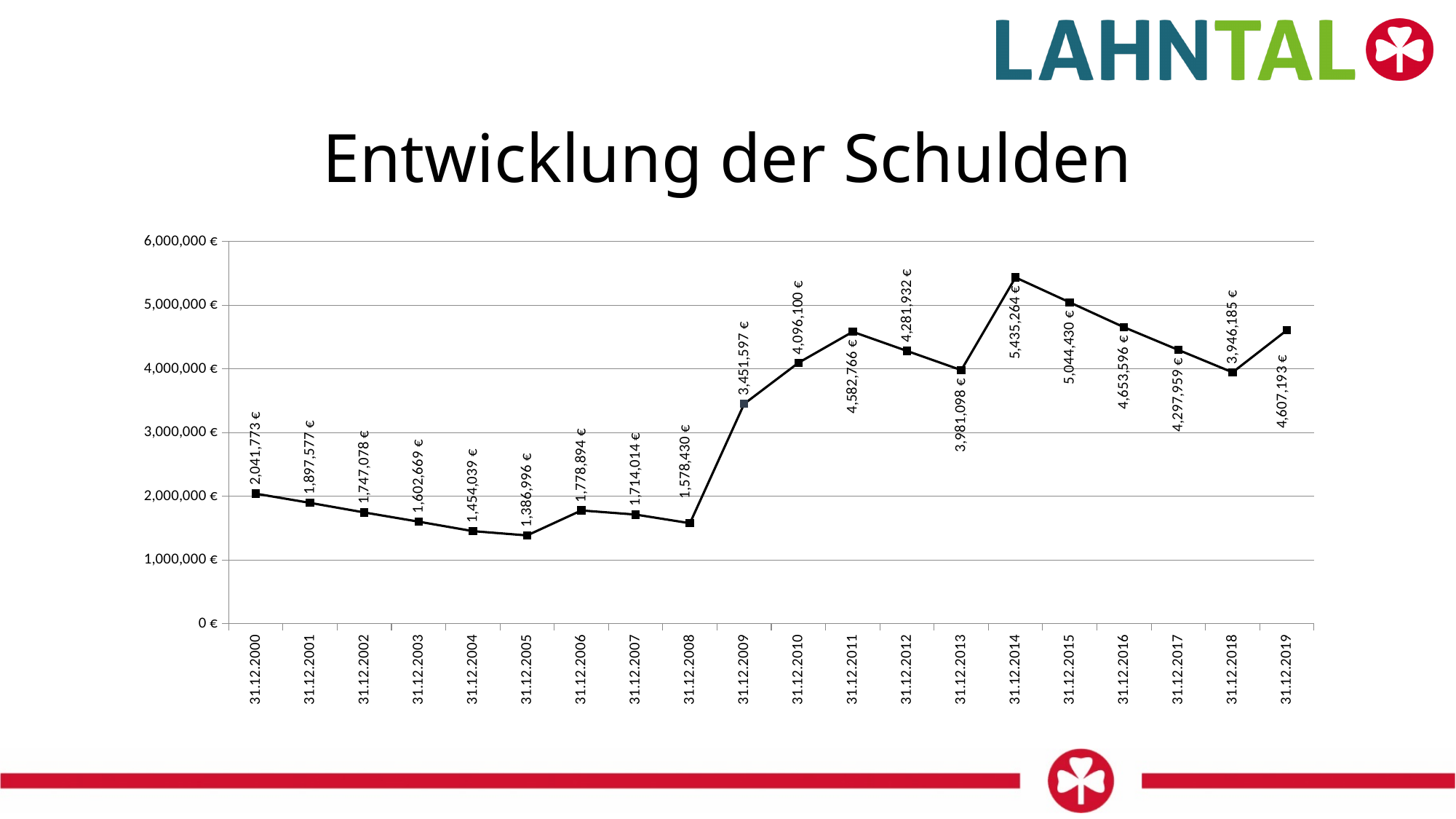
What is the difference between the values for 31.12.2009 and 31.12.2008? 1,873,167 € What type of chart is shown on the slide? line chart What is the difference between the values for 31.12.2014 and 31.12.2013? 1,454,166 € Which date has the highest value? 31.12.2014 What is the title of the chart? Entwicklung der Schulden How many data points are plotted on the chart? 20 Which is larger, the value for 31.12.2016 or the value for 31.12.2012? 31.12.2016 What is the value for 31.12.2009? 3,451,597 € Which date has the lowest value? 31.12.2005 What is the value for 31.12.2019? 4,607,193 € What is the value for 31.12.2000? 2,041,773 € Is the value for 31.12.2008 greater or less than 2,000,000 €? less